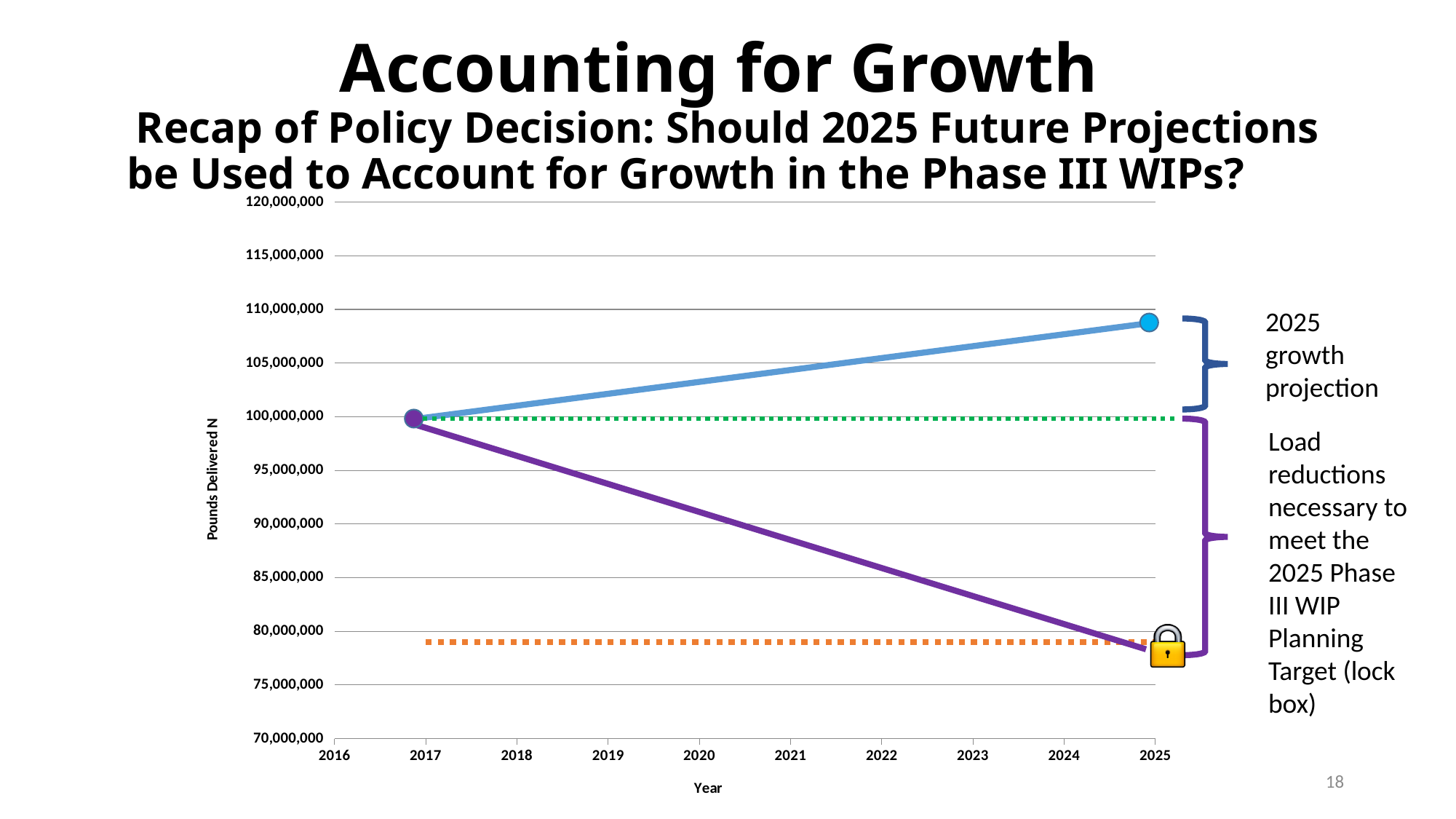
Is the value of the orange dotted line greater or less than 80,000,000? less How many year labels are shown on the horizontal axis? 10 Is the value of the blue line in 2025 greater or less than 110,000,000? less Is the value of the blue line in 2025 greater or less than 105,000,000? greater What is the title of the vertical axis of the chart? Pounds Delivered N What is the title of the horizontal axis of the chart? Year Does the blue line rise or fall from 2017 to 2025? rise In 2025, which line has the higher value, the blue line or the purple line? the blue line What kind of chart is shown on the slide? line chart Does the purple line rise or fall from 2017 to 2025? fall